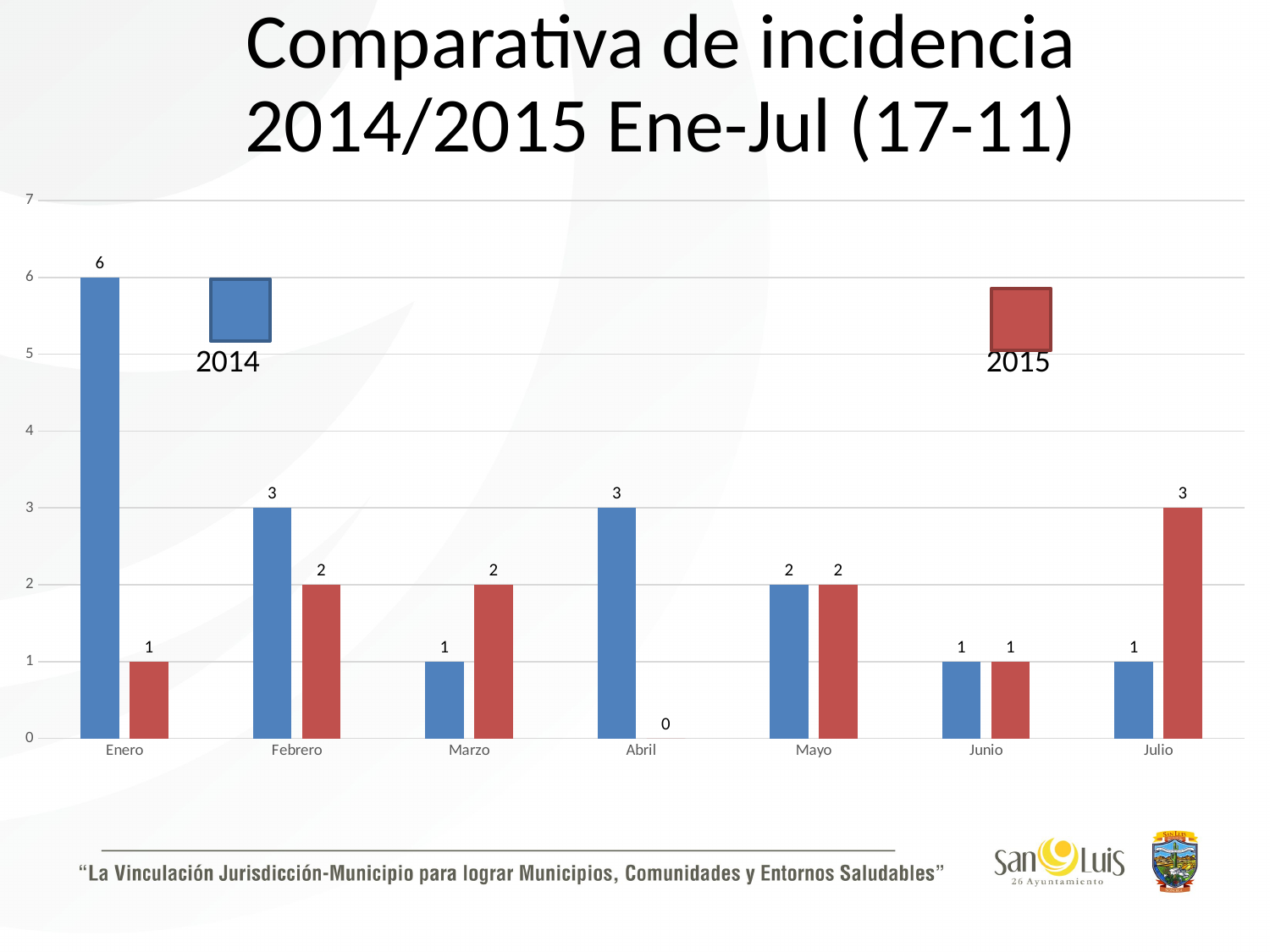
How many series does the legend list? 2 Which month has the lowest value for 2015? Abril What is the total of the 2014 and 2015 values in Mayo? 4 What is the value for 2015 in Julio? 3 Which month has the highest value for 2014? Enero What kind of chart is shown on the slide? bar chart What colour represents the 2015 series? red Which is larger in Marzo, the 2014 value or the 2015 value? 2015 What is the value for 2015 in Abril? 0 What is the difference between the 2014 and 2015 values in Enero? 5 What is the value for 2014 in Enero? 6 How many months are shown on the x axis? 7